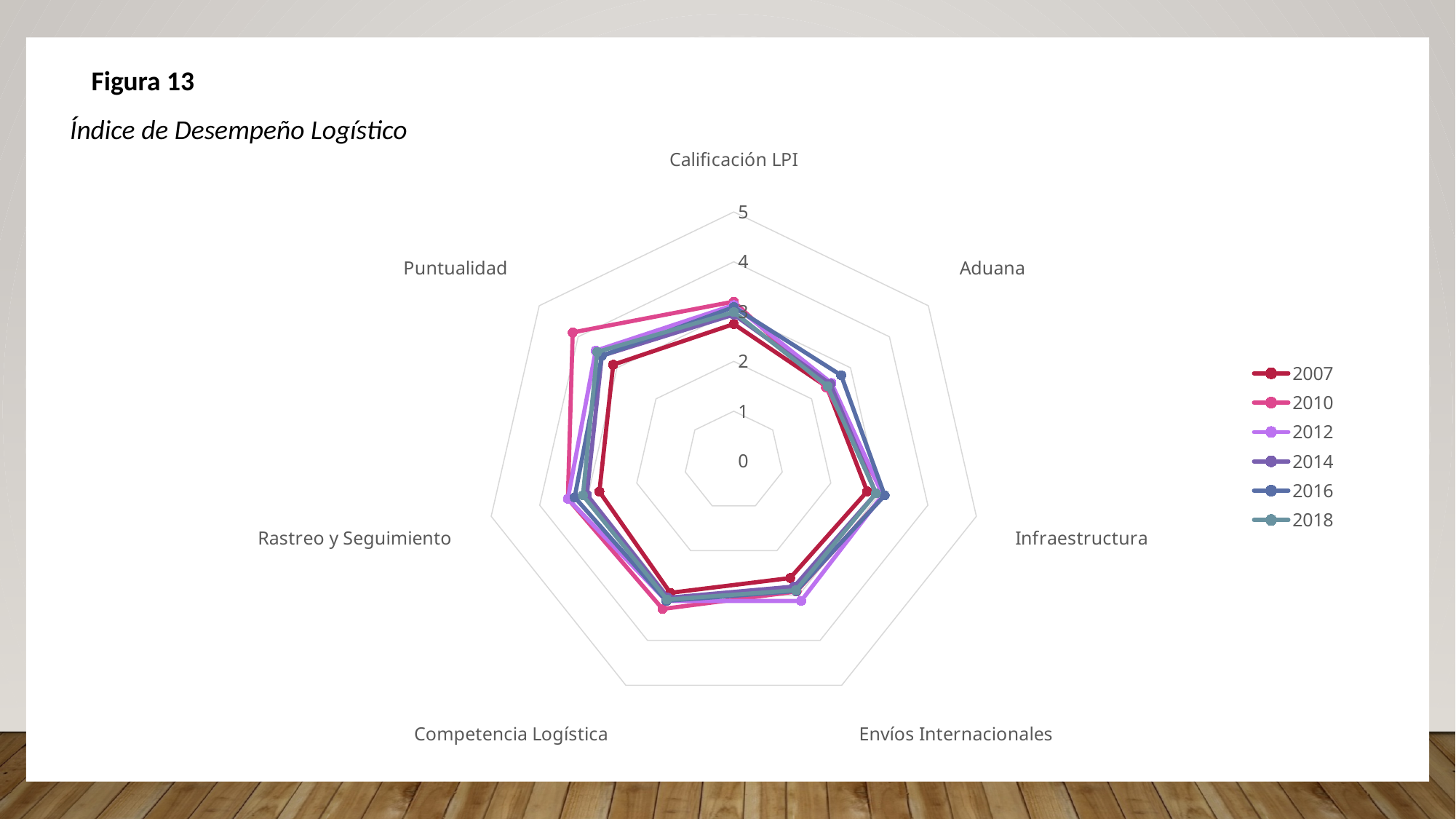
What kind of chart is shown on the slide? Radar chart Is the 2010 value for Puntualidad greater or less than 3? greater Is the 2007 value for Envíos Internacionales greater or less than 2? greater How many categories (axes) does the radar chart have? 7 Is the 2007 value for Aduana greater or less than 3? less For Puntualidad, which is larger: the 2007 value or the 2010 value? 2010 What is the title of the chart? Índice de Desempeño Logístico Which year has the highest value for Puntualidad? 2010 Which years are listed in the legend? 2007, 2010, 2012, 2014, 2016, 2018 How many series does the legend list? 6 Which year has the lowest value for Puntualidad? 2007